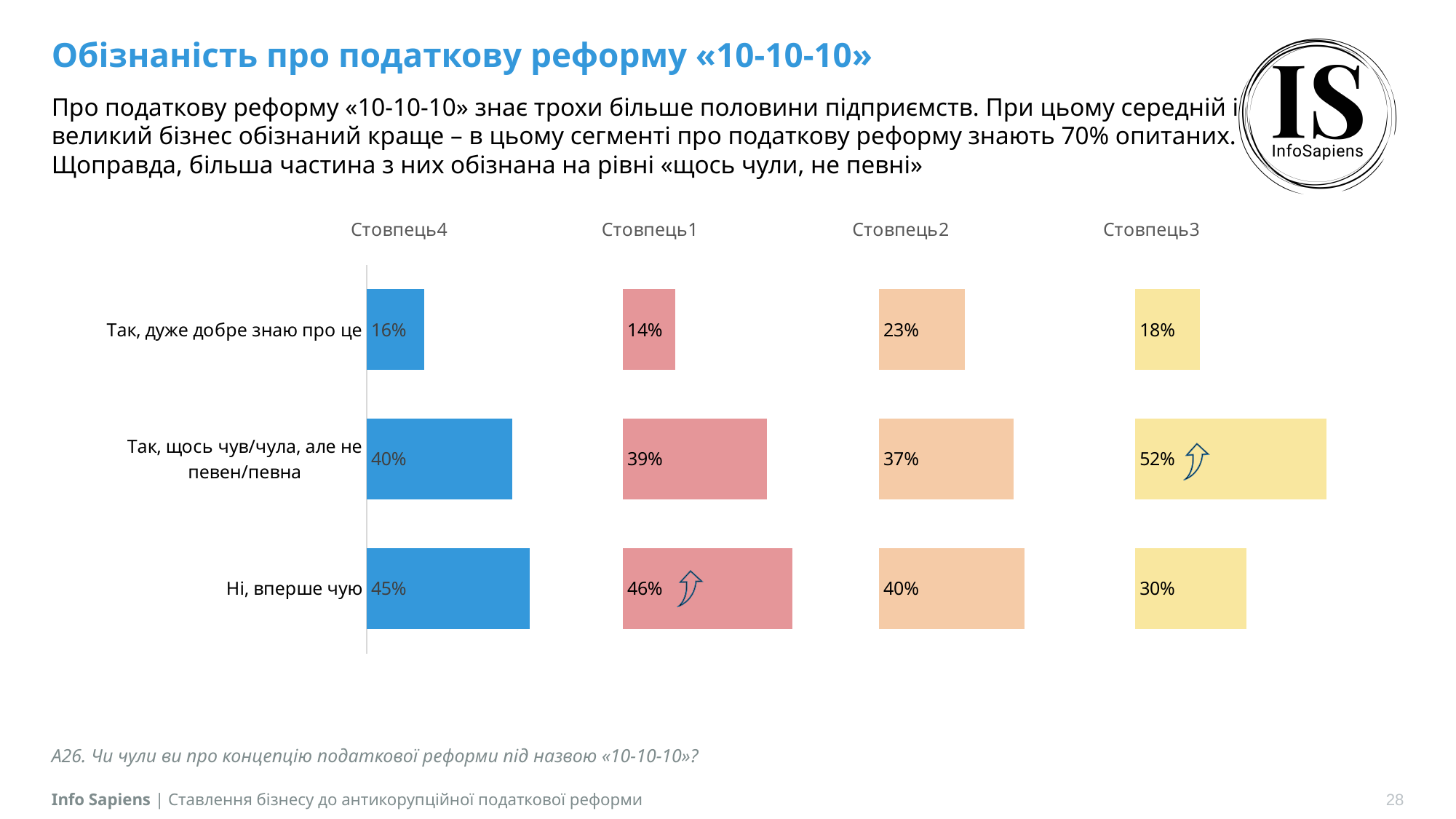
Which category has the lowest value in the Стовпець1 series? Так, дуже добре знаю про це Which is larger for «Так, дуже добре знаю про це»: the Стовпець2 value or the Стовпець3 value? Стовпець2 What kind of chart is shown on the slide? Bar chart What is the value for «Так, дуже добре знаю про це» in the Стовпець4 series? 16% Which category has the highest value in the Стовпець3 series? Так, щось чув/чула, але не певен/певна How many response categories are shown on the chart? 3 What is the difference between the Стовпець3 and Стовпець1 values for «Ні, вперше чую»? 16% What is the value for «Так, дуже добре знаю про це» in the Стовпець2 series? 23% What is the value for «Ні, вперше чую» in the Стовпець1 series? 46% What colour are the bars of the Стовпець4 series? Blue What is the value for «Так, щось чув/чула, але не певен/певна» in the Стовпець3 series? 52% How many series does the chart show? 4